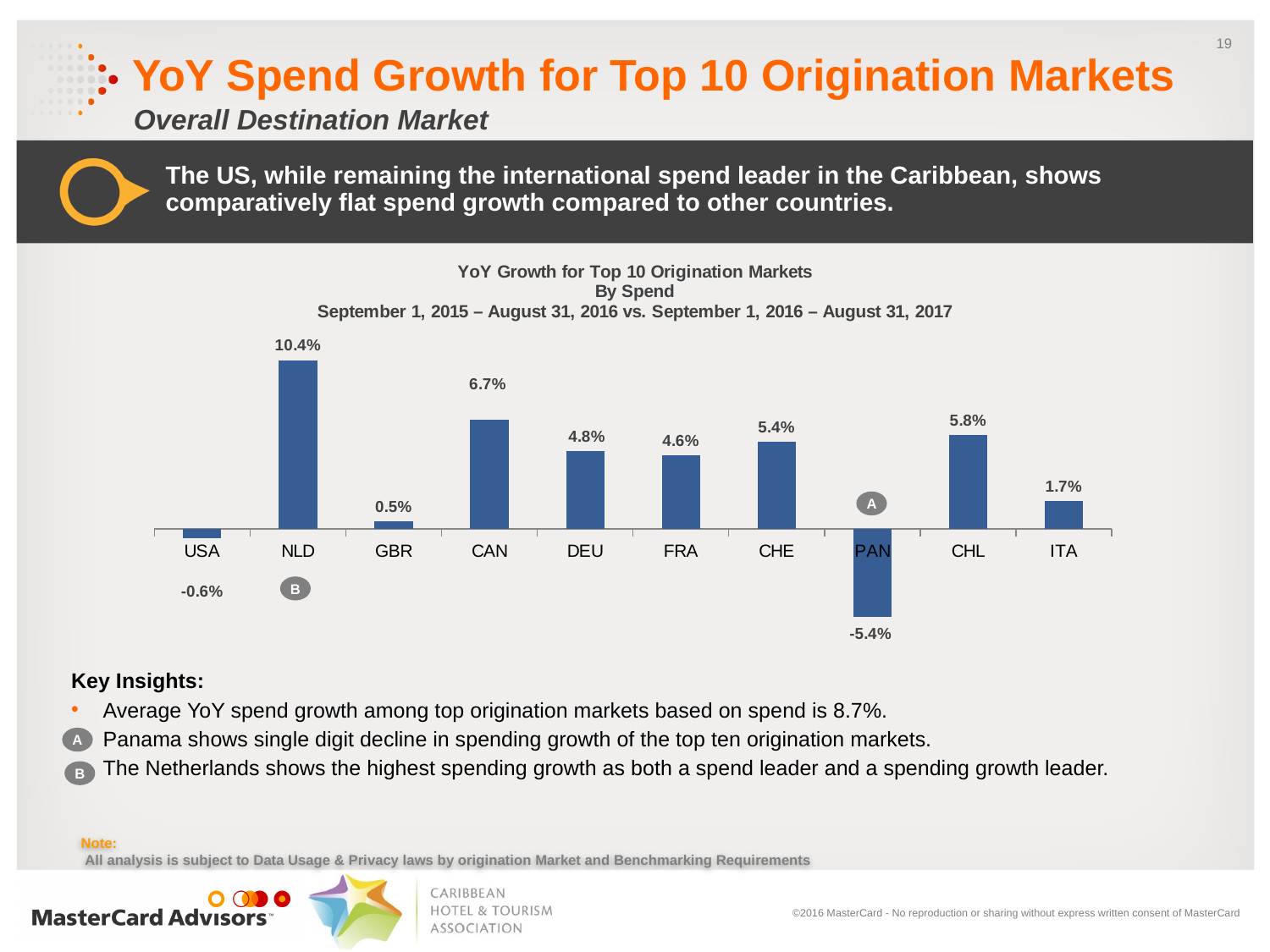
What is the difference between the YoY spend growth of ITA and GBR? 1.2% What is the YoY spend growth for NLD? 10.4% How many origination markets are shown in the chart? 10 What is the difference between the YoY spend growth of NLD and CAN? 3.7% What is the YoY spend growth for PAN? -5.4% What is the YoY spend growth for USA? -0.6% Which origination market has the highest YoY spend growth? NLD Which has higher YoY spend growth, CHE or DEU? CHE What type of chart is used to show YoY growth for the top 10 origination markets? Bar chart What is the title of the chart? YoY Growth for Top 10 Origination Markets By Spend What is the YoY spend growth for CHL? 5.8% Which origination market has the lowest YoY spend growth? PAN